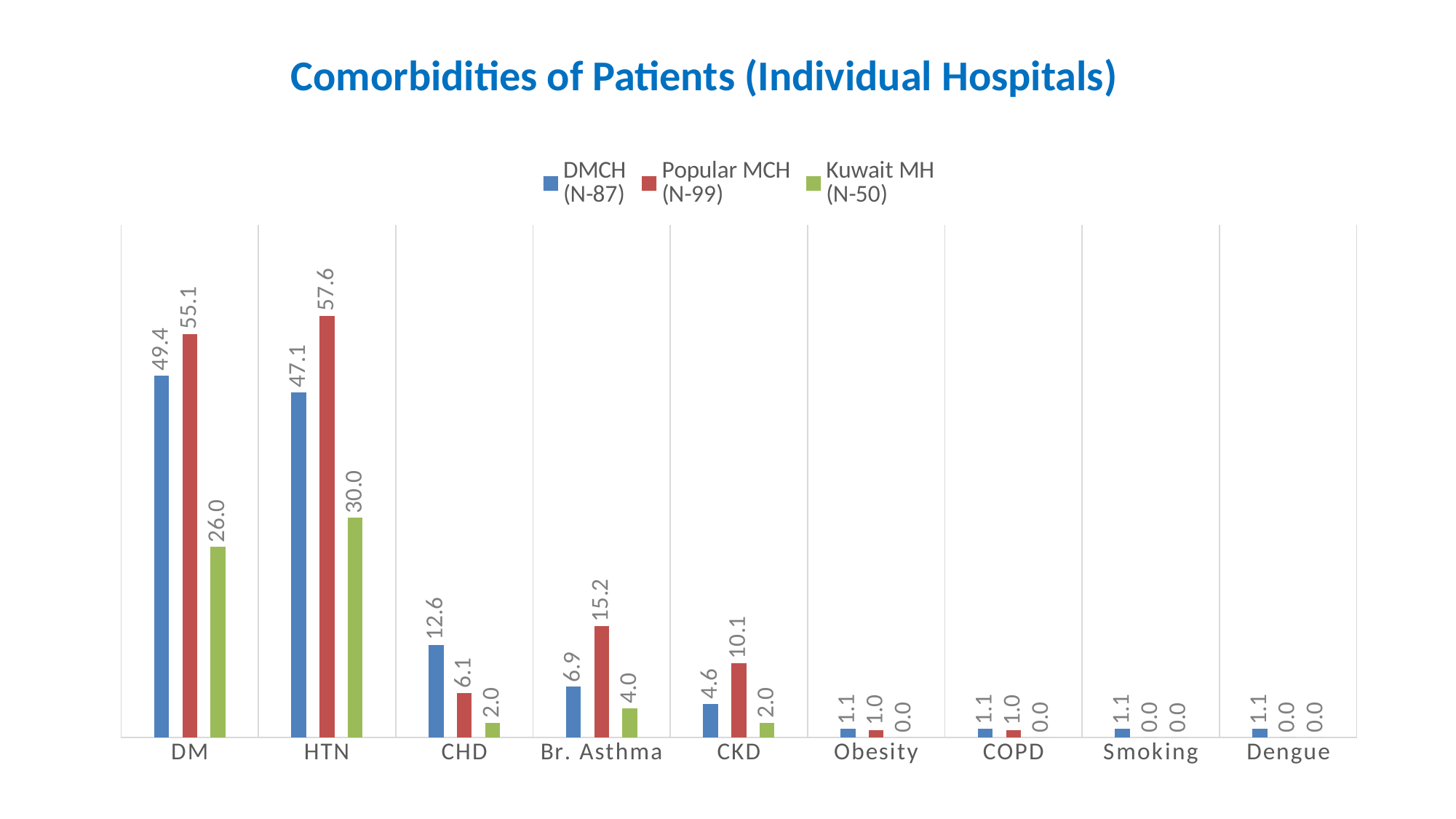
Which comorbidity has the highest value for DMCH (N-87)? DM Which is larger for Br. Asthma: the DMCH (N-87) value or the Popular MCH (N-99) value? Popular MCH (N-99) What is the value for Kuwait MH (N-50) for DM? 26.0 What is the value for DMCH (N-87) for CHD? 12.6 What is the value for Kuwait MH (N-50) for Smoking? 0.0 What is the title of the chart? Comorbidities of Patients (Individual Hospitals) How many comorbidity categories are shown on the x axis? 9 What is the difference between the Popular MCH (N-99) and DMCH (N-87) values for DM? 5.7 Which comorbidity has the highest value for Popular MCH (N-99)? HTN How many series does the legend list? 3 What is the value for Popular MCH (N-99) for HTN? 57.6 What kind of chart is shown on the slide? Bar chart